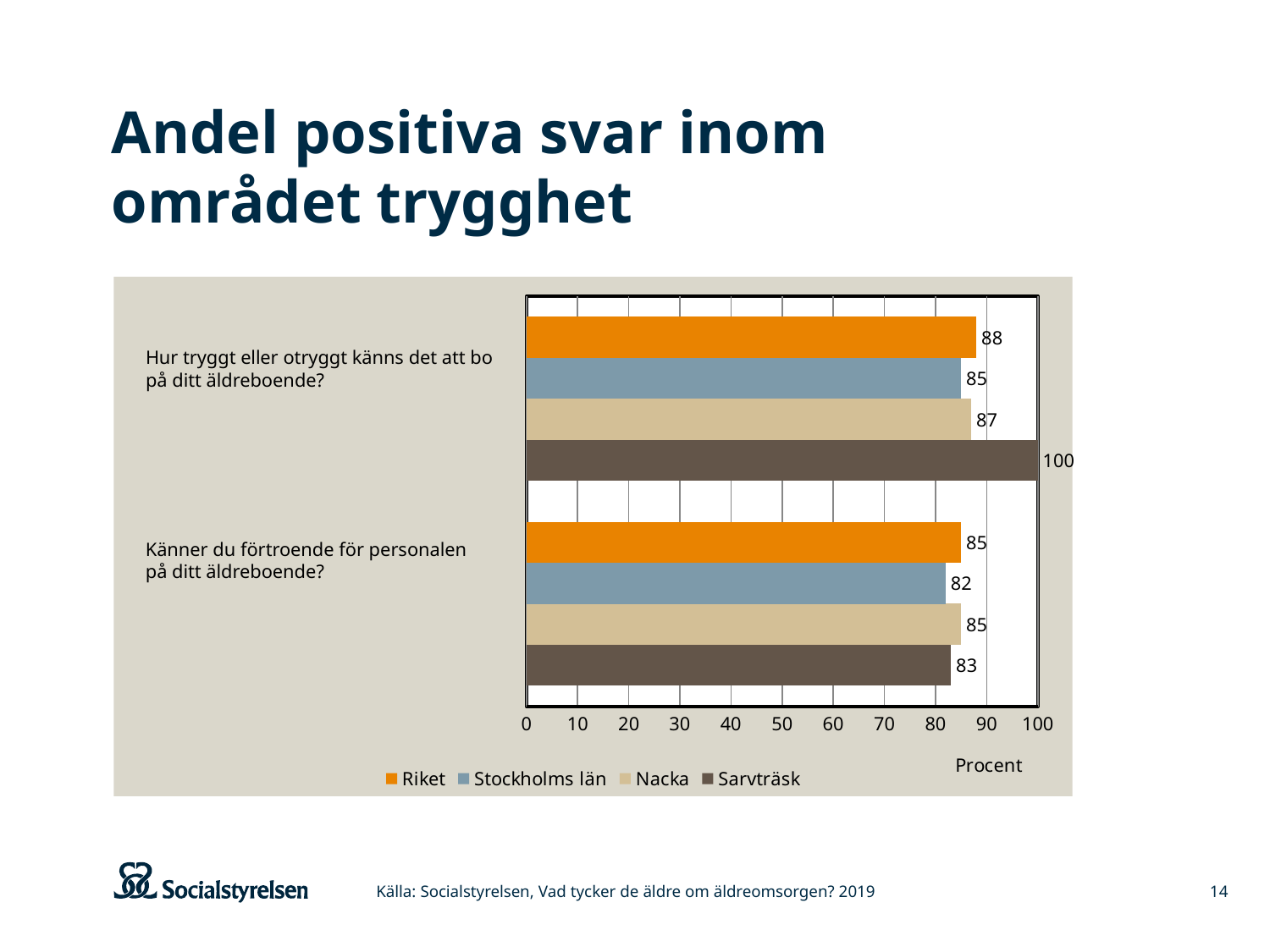
How many series does the legend list? 4 What is the value for Sarvträsk on the question "Hur tryggt eller otryggt känns det att bo på ditt äldreboende?"? 100 How many question categories are shown on the chart? 2 Which is larger on the question "Känner du förtroende för personalen på ditt äldreboende?": the value for Riket or the value for Sarvträsk? Riket What is the value for Stockholms län on the question "Känner du förtroende för personalen på ditt äldreboende?"? 82 Which series has the highest value on the question "Hur tryggt eller otryggt känns det att bo på ditt äldreboende?"? Sarvträsk What unit is shown on the x axis of the chart? Procent Which series has the lowest value on the question "Känner du förtroende för personalen på ditt äldreboende?"? Stockholms län What is the difference between the Sarvträsk value and the Stockholms län value on the question "Hur tryggt eller otryggt känns det att bo på ditt äldreboende?"? 15 What kind of chart is shown on the slide? Bar chart What is the value for Nacka on the question "Känner du förtroende för personalen på ditt äldreboende?"? 85 What is the value for Riket on the question "Hur tryggt eller otryggt känns det att bo på ditt äldreboende?"? 88